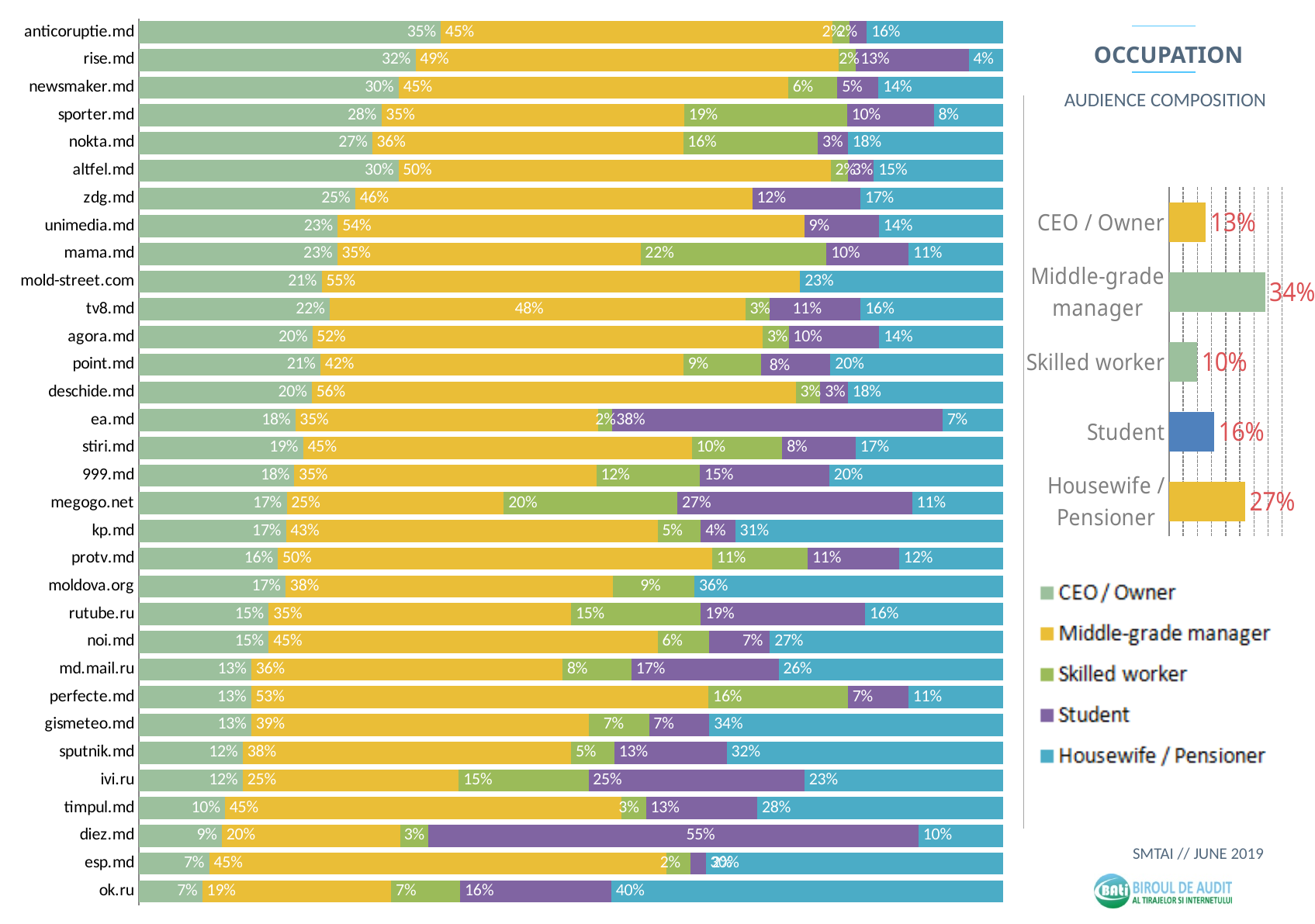
On the left stacked bar chart, what is the Housewife / Pensioner share for ok.ru? 40% On the left stacked bar chart, what is the Student share for diez.md? 55% On the left stacked bar chart, which website has the highest CEO / Owner share? anticoruptie.md On the right-hand 'Audience composition' chart, what is the difference between the Middle-grade manager value and the CEO / Owner value? 21 percentage points On the right-hand 'Audience composition' chart, what is the value for Middle-grade manager? 34% On the right-hand 'Audience composition' chart, which category has the lowest value? Skilled worker On the left stacked bar chart, what is the Middle-grade manager share for mold-street.com? 55% On the right-hand 'Audience composition' chart, which is larger: Student or Housewife / Pensioner? Housewife / Pensioner How many series does the legend of the left stacked bar chart list? 5 On the right-hand 'Audience composition' chart, which category has the highest value? Middle-grade manager How many websites are listed on the left stacked bar chart? 32 On the left stacked bar chart, which has the larger Student share: diez.md or ea.md? diez.md